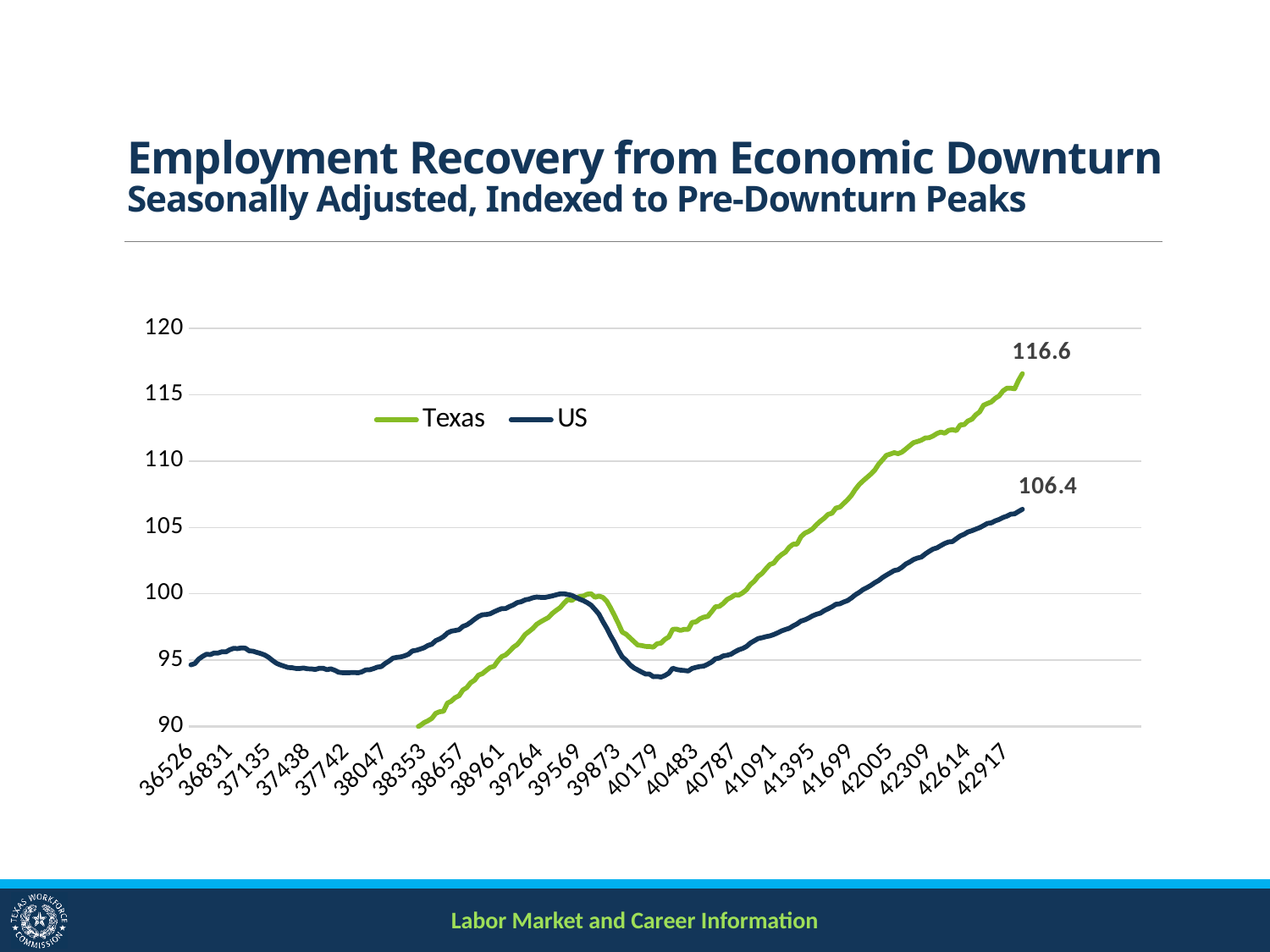
What colour is the Texas line? green What is the main title of the chart slide? Employment Recovery from Economic Downturn Which series ends at a higher value, Texas or US? Texas How many series does the legend list? 2 What kind of chart is shown on the slide? line chart Is the US value at 40179 greater or less than 95? less Does the Texas line rise or fall from 40179 to the end of the chart? rises What is the difference between the final labelled values for Texas and US? 10.2 Is the final value for Texas greater or less than 115? greater What is the final labelled value for the US series? 106.4 Is the final value for US greater or less than 110? less What is the final labelled value for the Texas series? 116.6